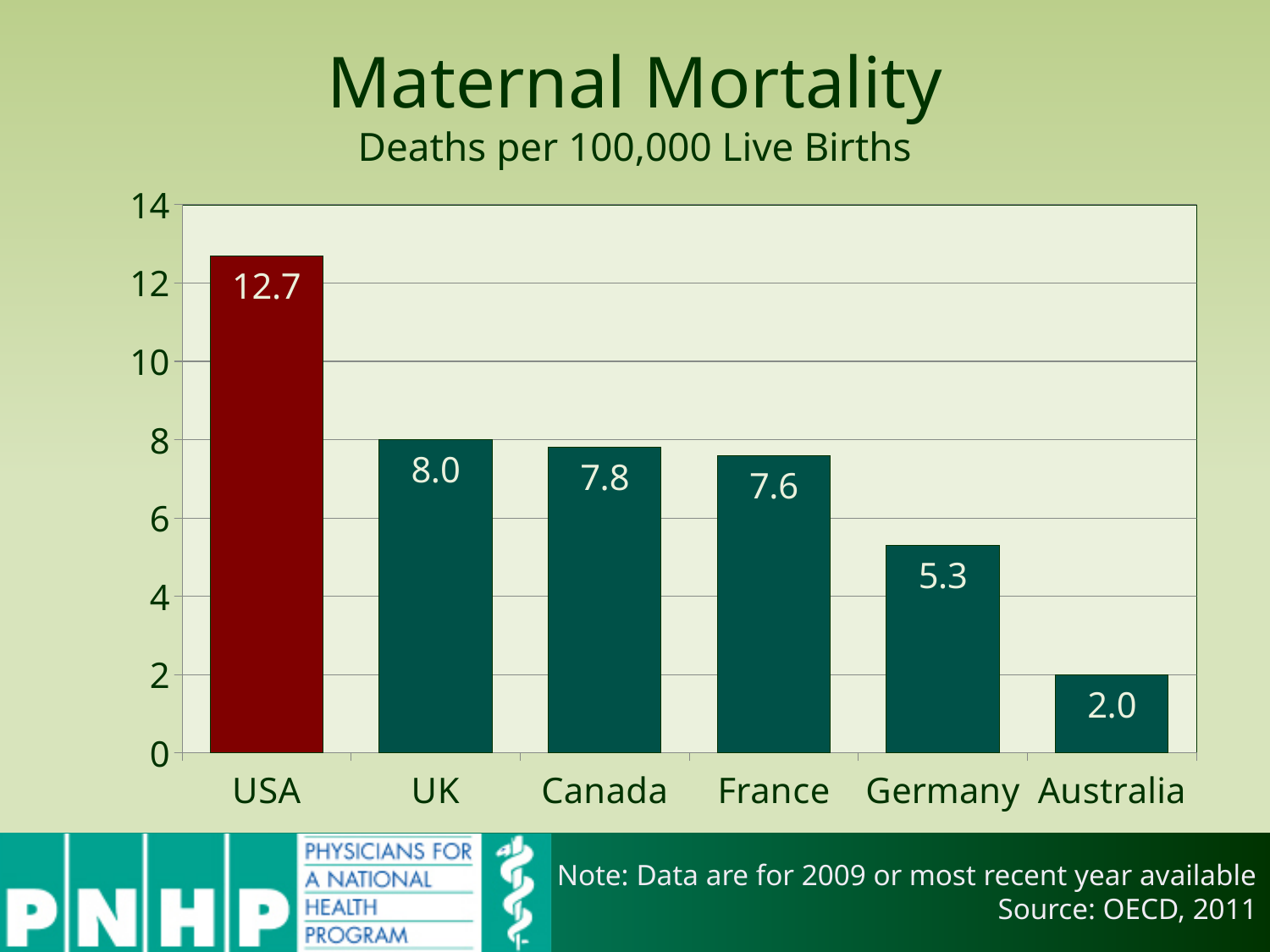
Which country has the lowest maternal mortality on the chart? Australia What is the difference between the USA and UK values? 4.7 How many countries are shown on the chart? 6 Which country has the highest maternal mortality on the chart? USA What is the difference between the Germany and Australia values? 3.3 Which country's bar is coloured red rather than green? USA What kind of chart is shown on the slide? bar chart Is the value for France greater or less than 10? less What is the maternal mortality value for Germany? 5.3 What is the maternal mortality value for Australia? 2.0 Which has a higher maternal mortality value, Canada or Germany? Canada What is the maternal mortality value for the USA? 12.7